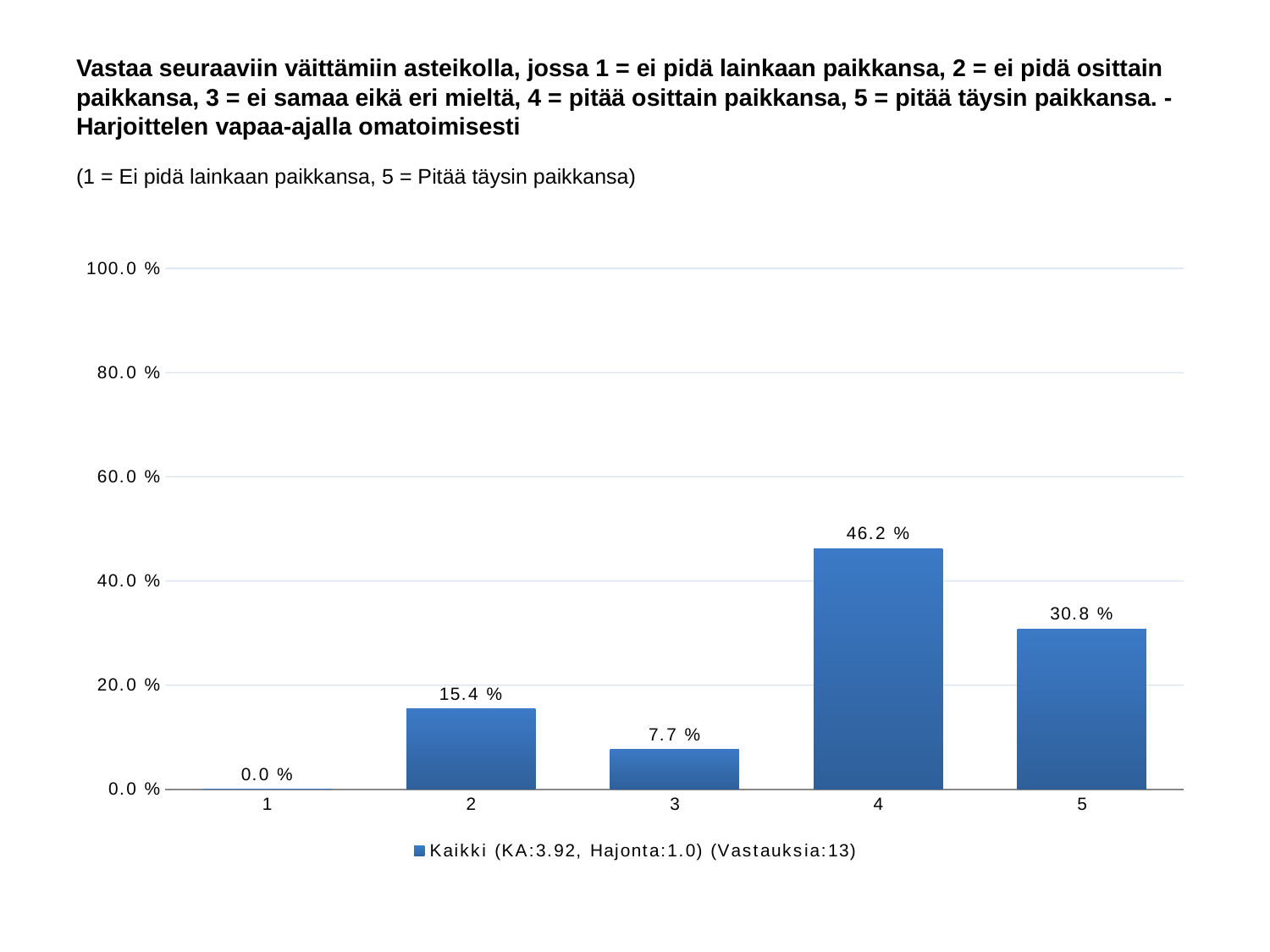
Which category has the lowest value? 1 What kind of chart is shown on the slide? bar chart How many categories are shown on the x axis? 5 How many responses (Vastauksia) does the legend report? 13 What is the value for category 4? 46.2 % What is the difference between the values for category 4 and category 5? 15.4 % Which category has the highest value? 4 What is the value for category 5? 30.8 % What is the value for category 1? 0.0 % What is the value for category 2? 15.4 % Is the value for category 4 greater or less than 40.0 %? greater Which is larger, the value for category 2 or category 3? 2